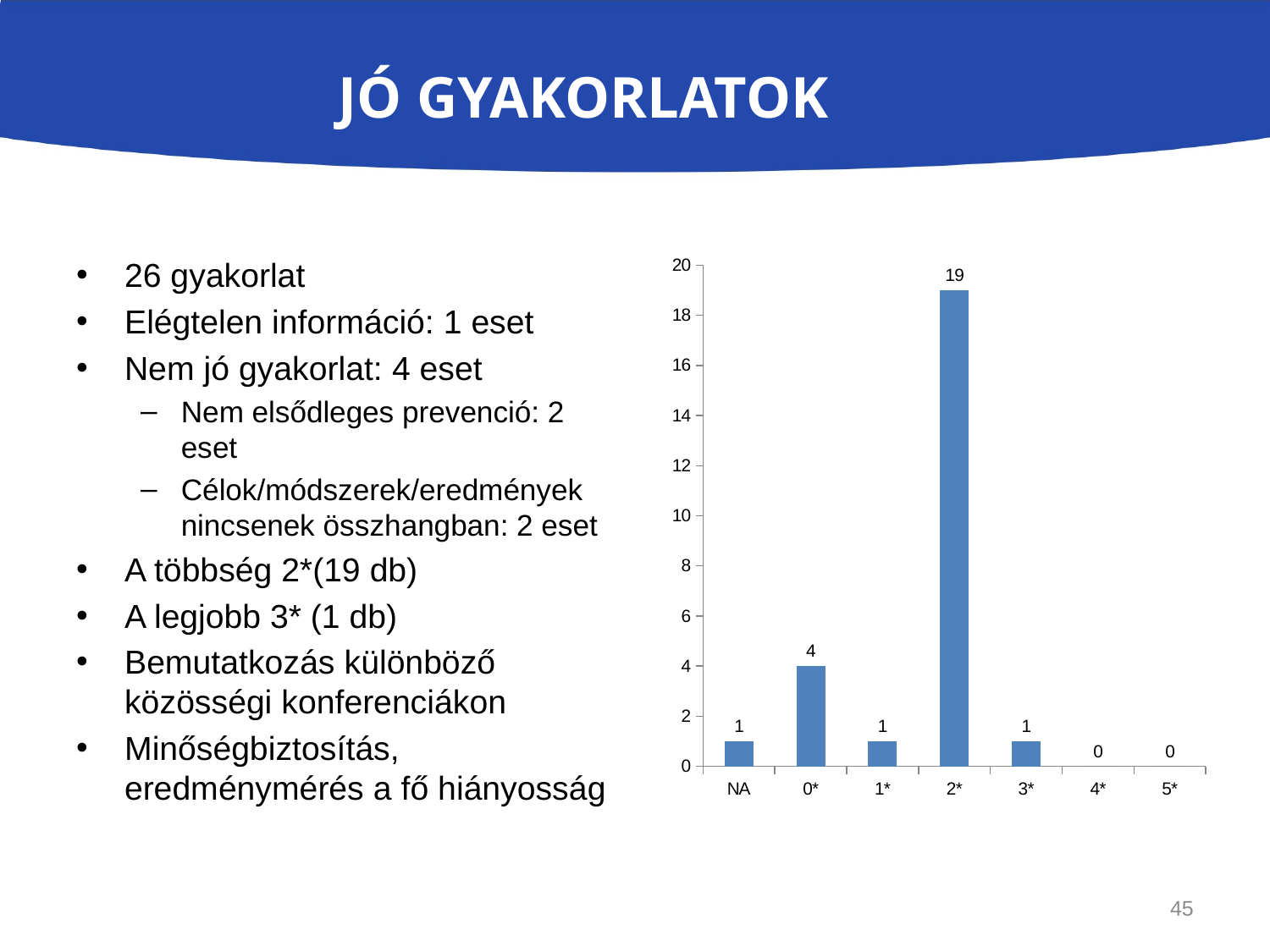
What is the value for the 5* category? 0 What is the value for the 0* category? 4 How many categories have a value of 0? 2 Which is larger, the value for 0* or the value for 3*? 0* What is the difference between the values for 2* and 0*? 15 How many categories are shown on the x axis? 7 Is the value for 2* greater or less than 18? greater What kind of chart is shown on the slide? bar chart What is the value for the NA category? 1 What is the value for the 2* category? 19 What is the maximum value shown on the y axis? 20 Which category has the highest value? 2*